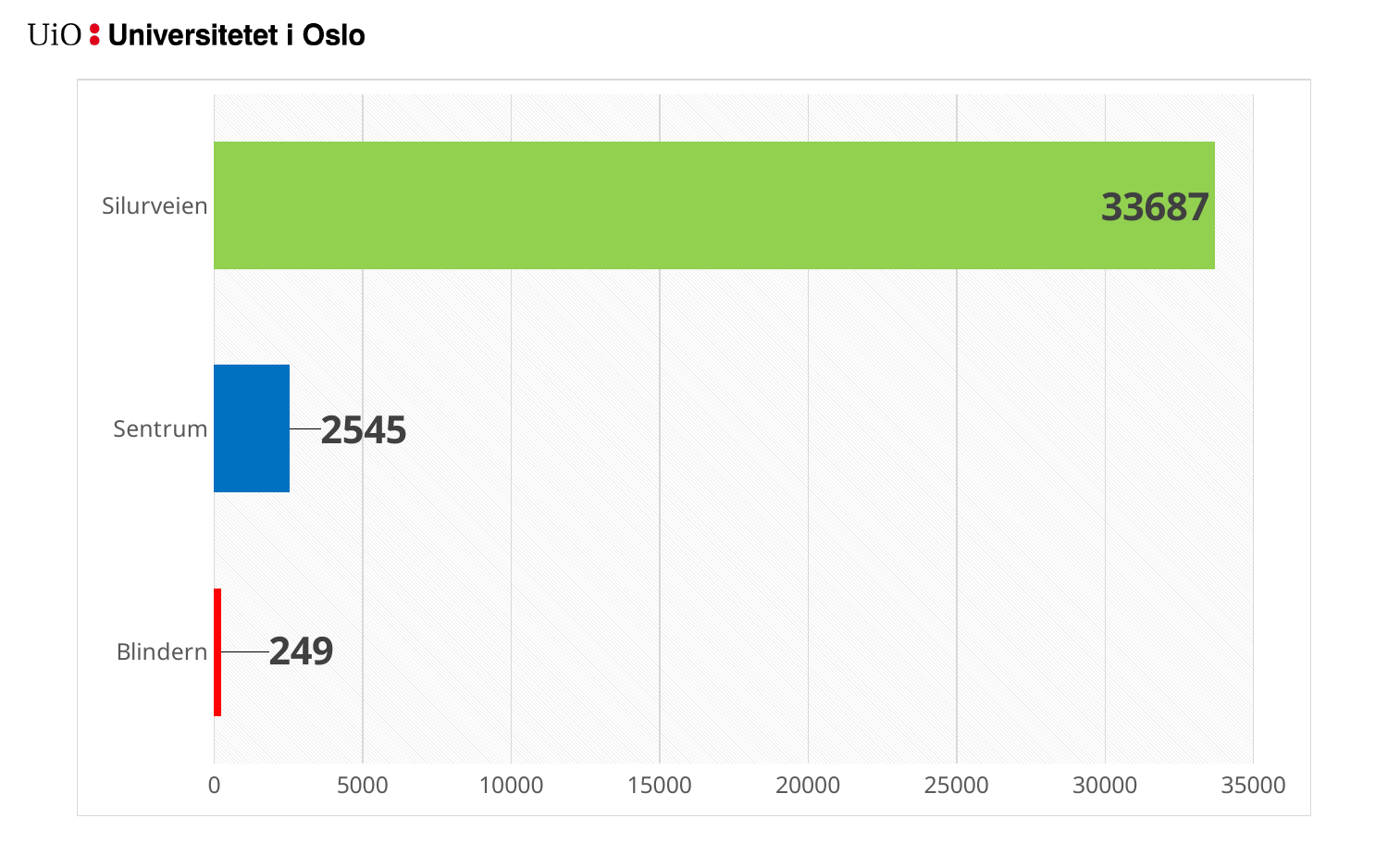
What is the difference between the values for Sentrum and Blindern? 2296 What kind of chart is shown on the slide? bar chart Which category has the highest value? Silurveien What is the value for Sentrum? 2545 What colour is the bar for Blindern? red Which category has the lowest value? Blindern What is the difference between the values for Silurveien and Sentrum? 31142 What is the value for Blindern? 249 Is the value for Silurveien greater or less than 30000? greater Which is larger, the value for Sentrum or the value for Blindern? Sentrum What is the value for Silurveien? 33687 How many categories are shown in the chart? 3